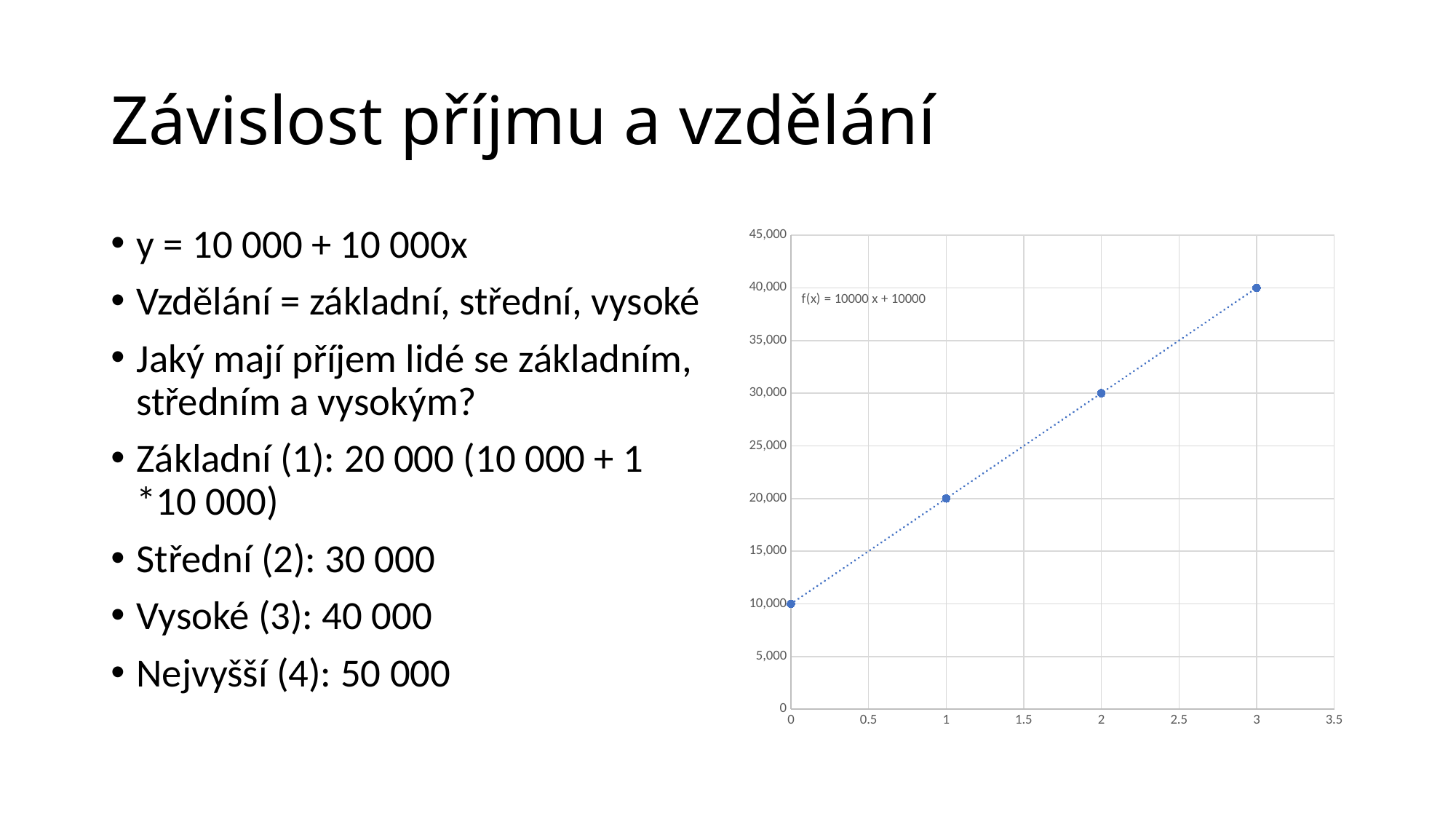
At which x value is the plotted y value highest? 3 At which x value is the plotted y value lowest? 0 What is the difference between the y values at x = 3 and x = 1? 20,000 What trendline equation is displayed on the chart? f(x) = 10000 x + 10000 What is the y value of the point at x = 2? 30,000 Do the plotted values rise or fall as x increases? rise Which has a larger y value: the point at x = 2 or the point at x = 1? x = 2 How many data points are plotted in the chart? 4 What kind of chart is shown on the slide? scatter chart What is the y value of the point at x = 0? 10,000 What is the y value of the point at x = 1? 20,000 What is the y value of the point at x = 3? 40,000